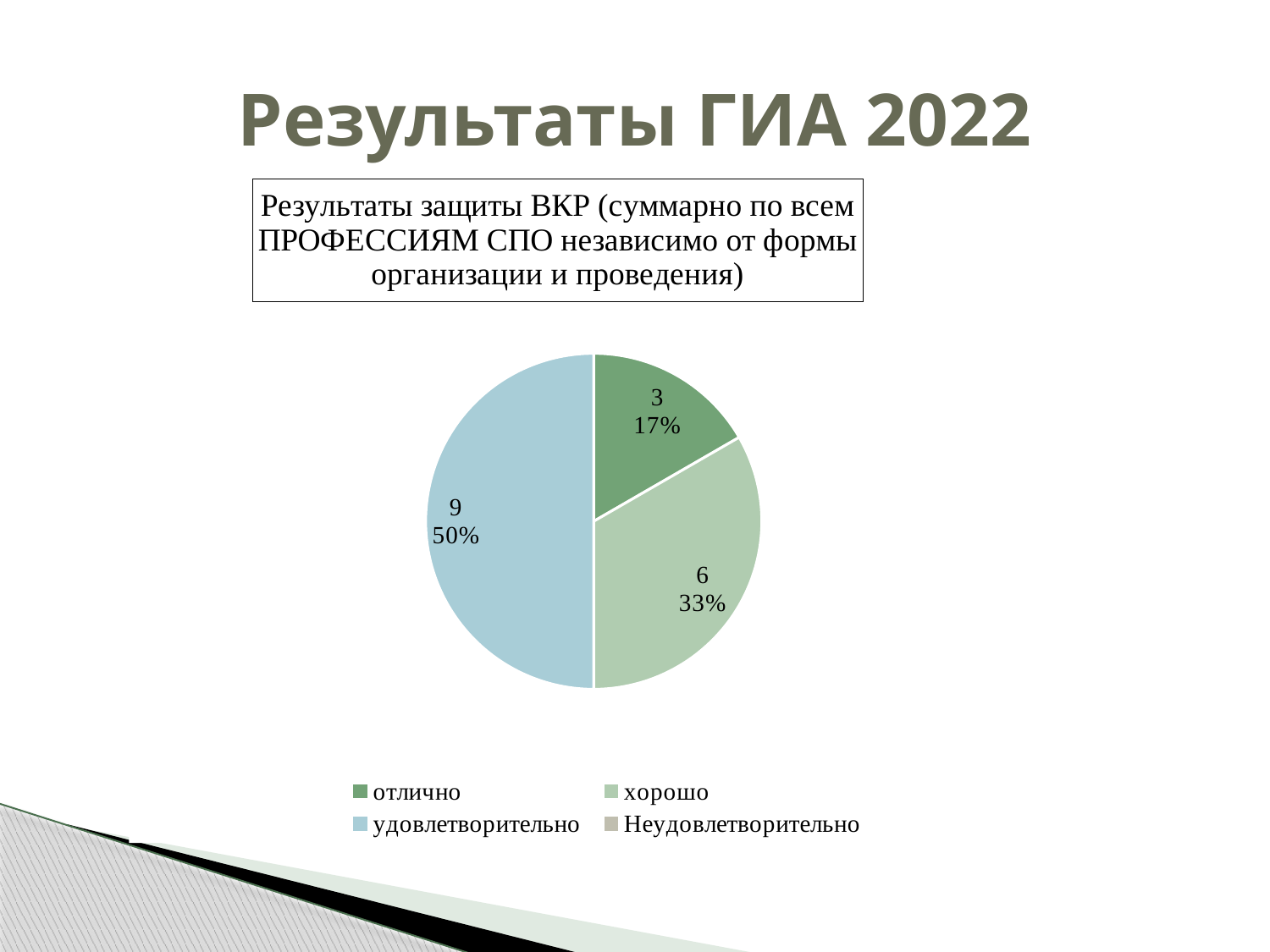
Which category has the largest slice? удовлетворительно What is the value for отлично? 3 How many entries does the legend list? 4 What kind of chart is shown on the slide? pie chart What is the difference between the values for удовлетворительно and отлично? 6 What is the value for хорошо? 6 What is the value for удовлетворительно? 9 Which of the visible slices is the smallest? отлично What share of the pie does удовлетворительно take? 50% How many slices are visible in the pie chart? 3 What share of the pie does отлично take? 17% Which is larger, the value for хорошо or the value for отлично? хорошо